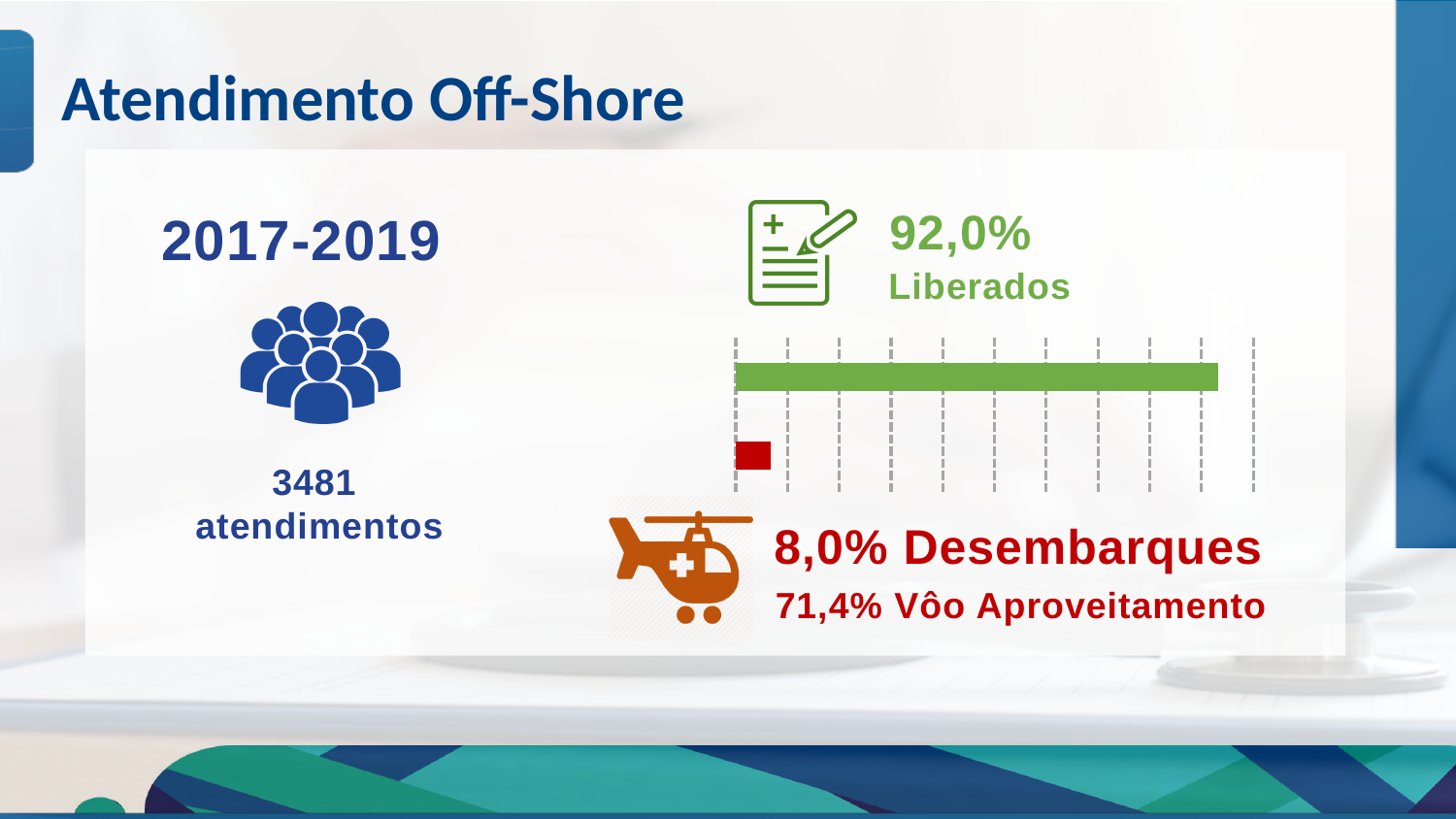
Which category has the lowest value in the bar chart? Desembarques Which category has the longer bar, Liberados or Desembarques? Liberados What percentage is given for Vôo Aproveitamento? 71,4% What kind of chart is shown on the slide? bar chart What colour is the bar for Desembarques? red What colour is the bar for Liberados? green What percentage is shown for Liberados? 92,0% How many bars are plotted in the chart? 2 What is the difference in percentage points between Liberados and Desembarques? 84,0 What is the combined percentage of Liberados and Desembarques? 100,0% What percentage is shown for Desembarques? 8,0% Which category has the highest value in the bar chart? Liberados